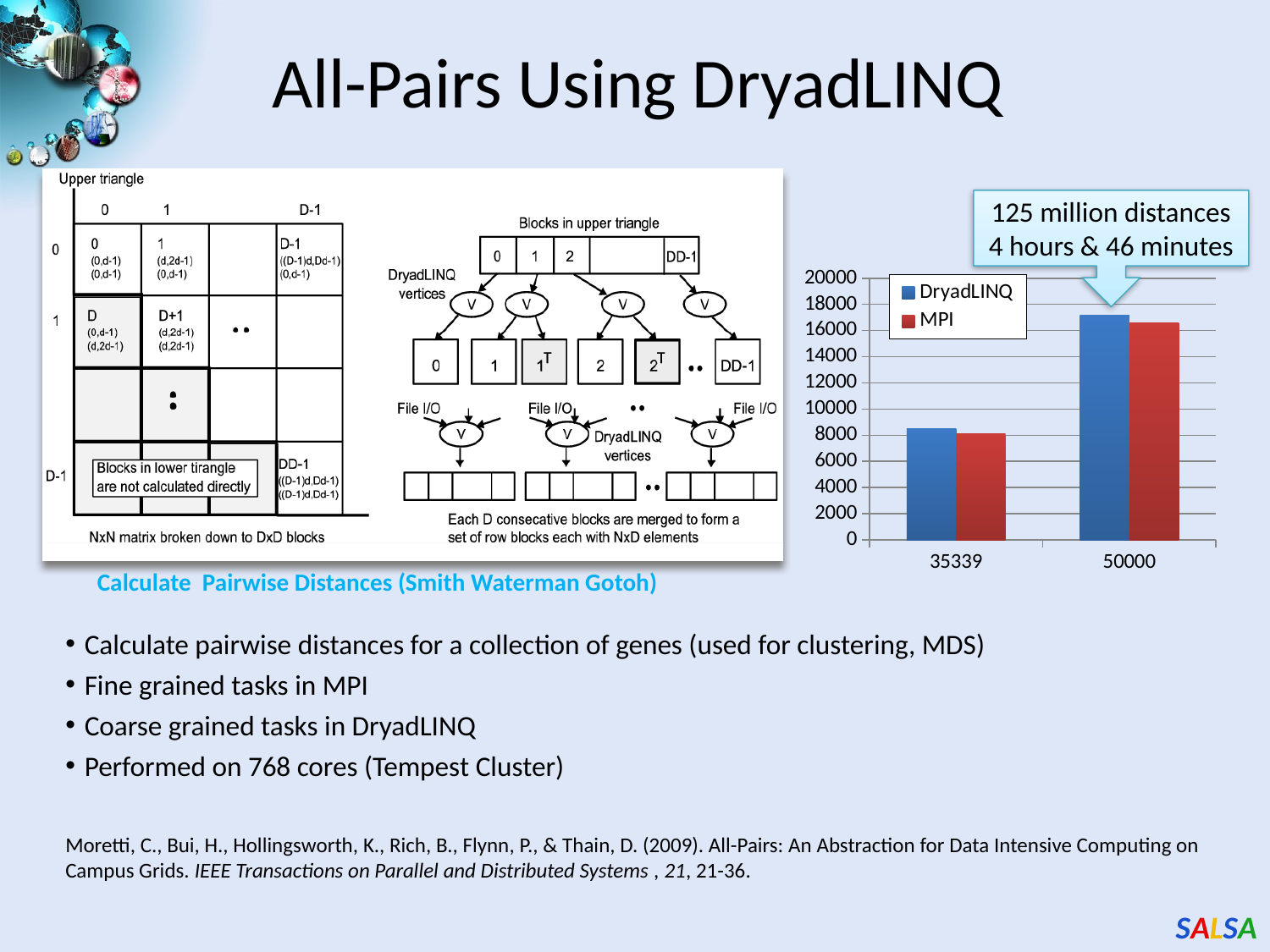
How many series does the chart's legend list? 2 How many categories are shown on the x axis of the chart? 2 Is the MPI value for 50000 greater or less than 18000? less Do the DryadLINQ values rise or fall from 35339 to 50000? rise Which category has the higher DryadLINQ value, 35339 or 50000? 50000 Which category has the lowest MPI value? 35339 Is the MPI value for 35339 greater or less than 10000? less For the 50000 category, which series has the larger value, DryadLINQ or MPI? DryadLINQ Is the DryadLINQ value for 35339 greater or less than 8000? greater What are the two series named in the chart's legend? DryadLINQ and MPI What kind of chart is shown on the slide? bar chart